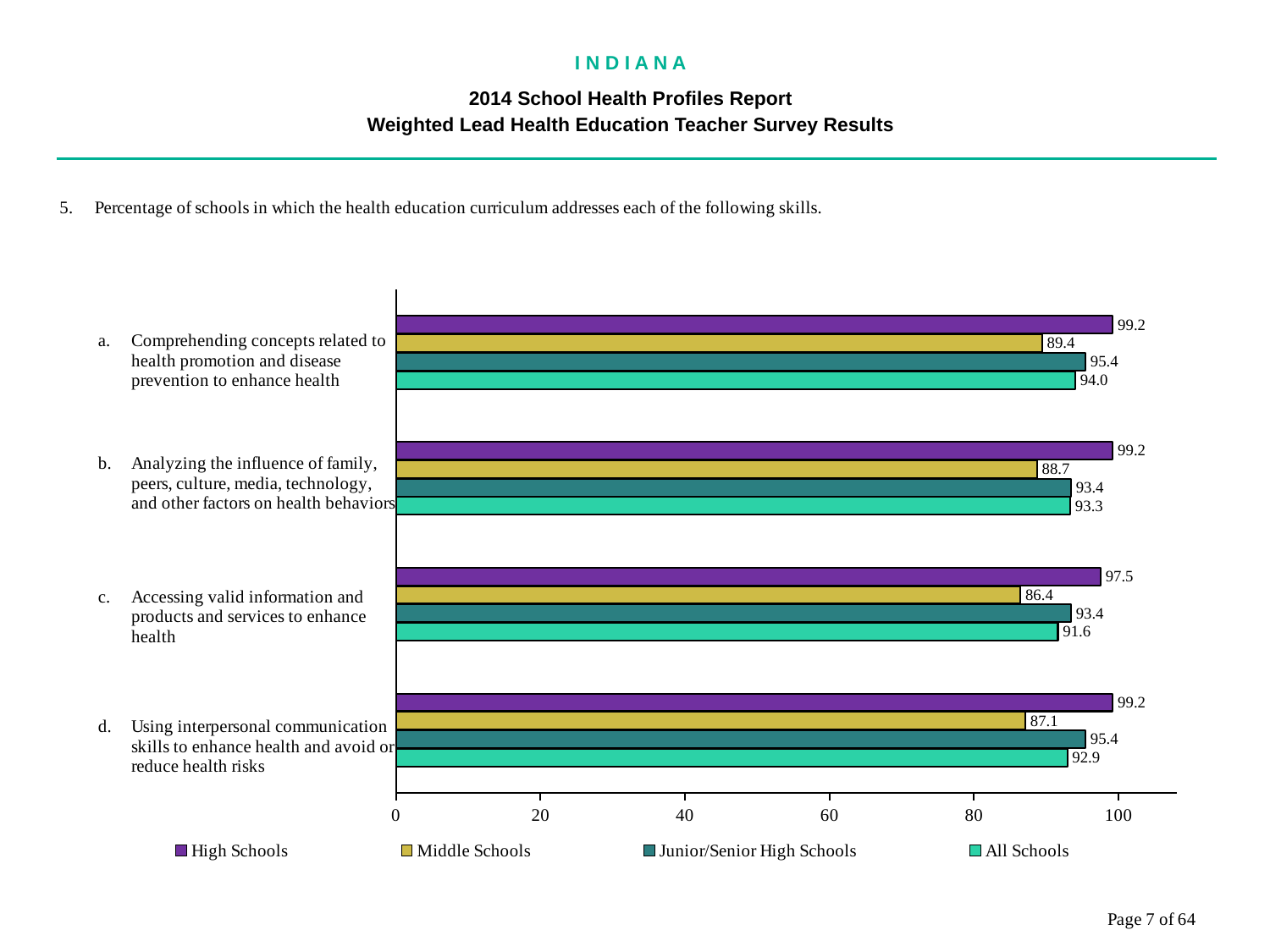
What is the value for Middle Schools for skill c, accessing valid information and products and services to enhance health? 86.4 How many skills (categories) are shown on the chart? 4 How many series does the legend list? 4 Which is larger for skill b: the Junior/Senior High Schools value or the All Schools value? Junior/Senior High Schools Which school type has the highest value for skill c, accessing valid information and products and services? High Schools What is the value for High Schools for skill a, comprehending concepts related to health promotion and disease prevention to enhance health? 99.2 Which school type has the lowest value for skill d, using interpersonal communication skills? Middle Schools What is the value for Junior/Senior High Schools for skill b, analyzing the influence of family, peers, culture, media, technology, and other factors on health behaviors? 93.4 What is the value for All Schools for skill d, using interpersonal communication skills to enhance health and avoid or reduce health risks? 92.9 Is the Middle Schools value for skill c, accessing valid information, greater or less than 80? greater What kind of chart is shown on the slide? Bar chart What is the difference between the High Schools and Middle Schools values for skill a, comprehending concepts related to health promotion? 9.8